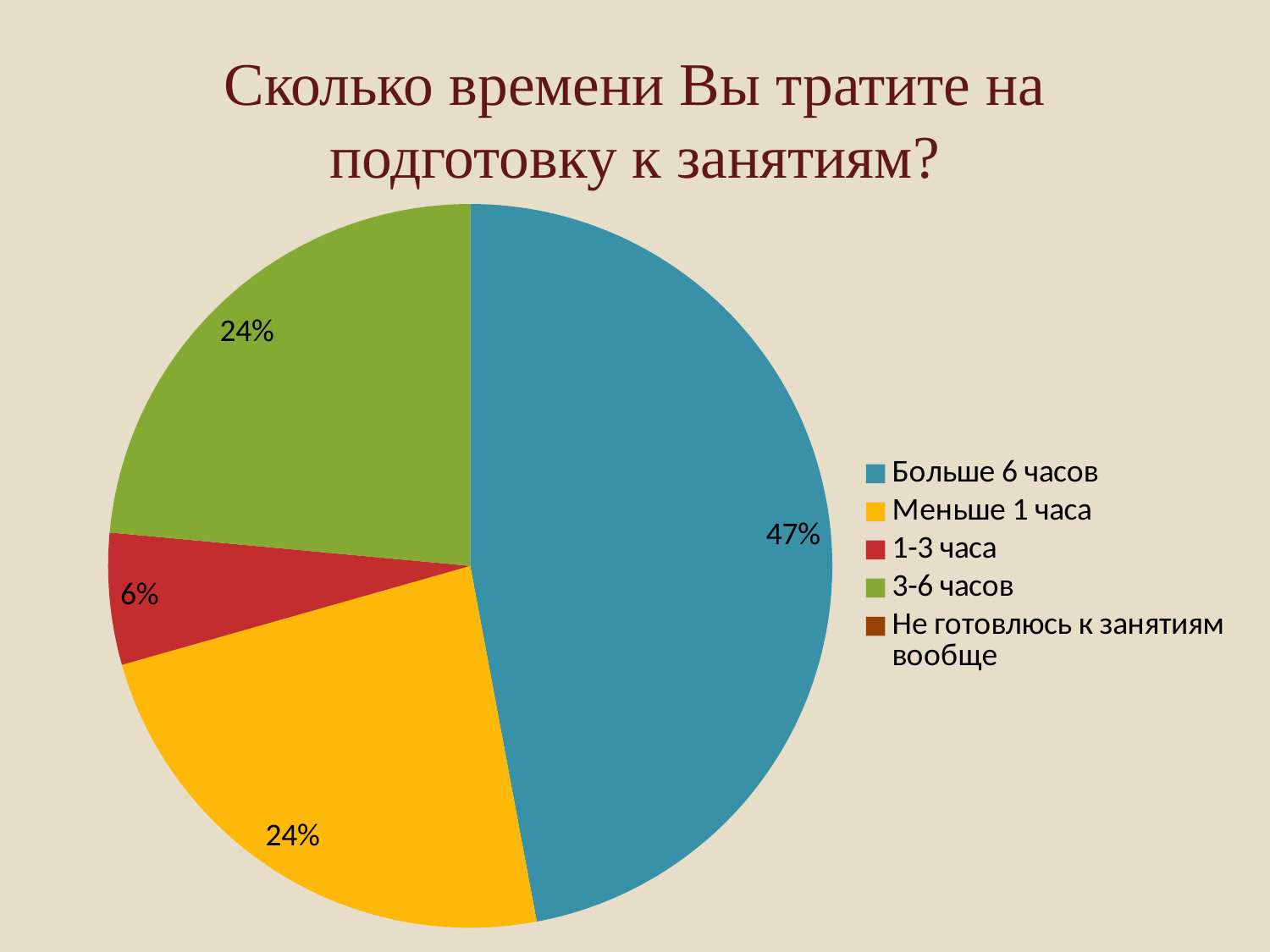
What colour is the slice for '3-6 часов'? Green What is the value shown for '1-3 часа'? 6% What is the value shown for 'Меньше 1 часа'? 24% How many entries does the legend list? 5 What share of the pie does the 'Больше 6 часов' slice represent? 47% What is the value shown for '3-6 часов'? 24% Which is larger, the slice for 'Больше 6 часов' or the slice for 'Меньше 1 часа'? Больше 6 часов Among the slices visible on the pie, which category has the smallest slice? 1-3 часа What is the difference in percentage points between 'Больше 6 часов' and '3-6 часов'? 23 percentage points Which category has the largest slice of the pie? Больше 6 часов What is the title of the chart? Сколько времени Вы тратите на подготовку к занятиям? What kind of chart is shown on the slide? Pie chart